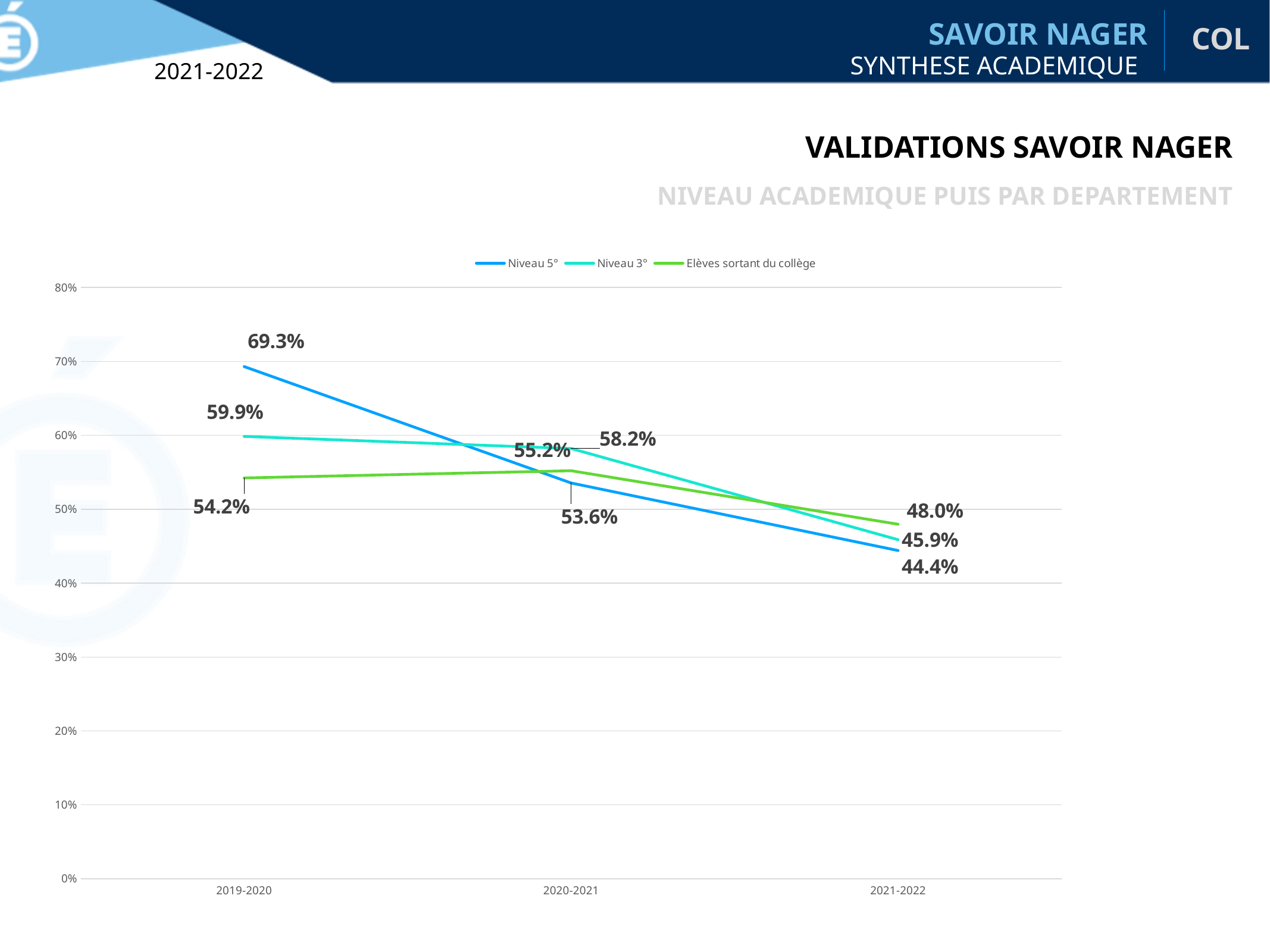
What is the value for Elèves sortant du collège in 2021-2022? 48.0% How many school years are shown on the x axis? 3 Which series has the highest value in 2019-2020? Niveau 5° Does the Niveau 5° series rise or fall from 2019-2020 to 2021-2022? fall What type of chart is shown on the slide? line chart How many series does the legend list? 3 Which series has the lowest value in 2021-2022? Niveau 5° What is the value for Niveau 5° in 2021-2022? 44.4% What is the difference between the Niveau 5° values in 2019-2020 and 2021-2022? 24.9% What is the value for Niveau 3° in 2020-2021? 58.2% What is the value for Niveau 3° in 2019-2020? 59.9% What is the value for Niveau 5° in 2019-2020? 69.3%